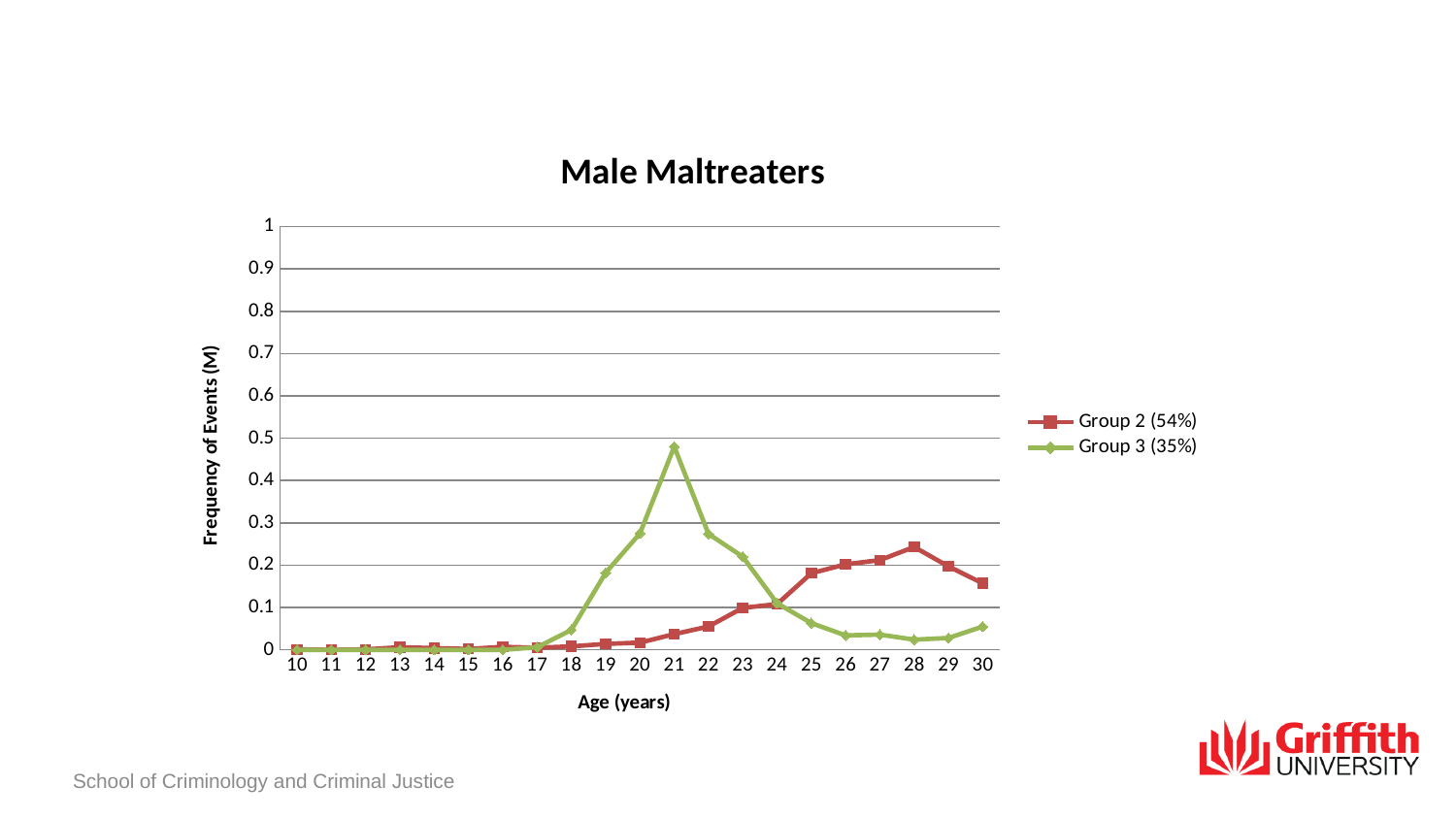
What is the label of the y axis? Frequency of Events (M) At which age does Group 3 (35%) reach its highest value? 21 How many series does the legend list? 2 Is the value for Group 3 (35%) at age 21 greater or less than 0.4? greater What kind of chart is shown on the slide? line chart Is the value for Group 2 (54%) at age 28 greater or less than 0.3? less At age 21, which series has the larger value, Group 2 (54%) or Group 3 (35%)? Group 3 (35%) At which age does Group 2 (54%) reach its highest value? 28 At age 27, which series has the larger value, Group 2 (54%) or Group 3 (35%)? Group 2 (54%) Is the value for Group 3 (35%) at age 26 greater or less than 0.1? less What is the title of the chart? Male Maltreaters How many age points are plotted along the x axis? 21